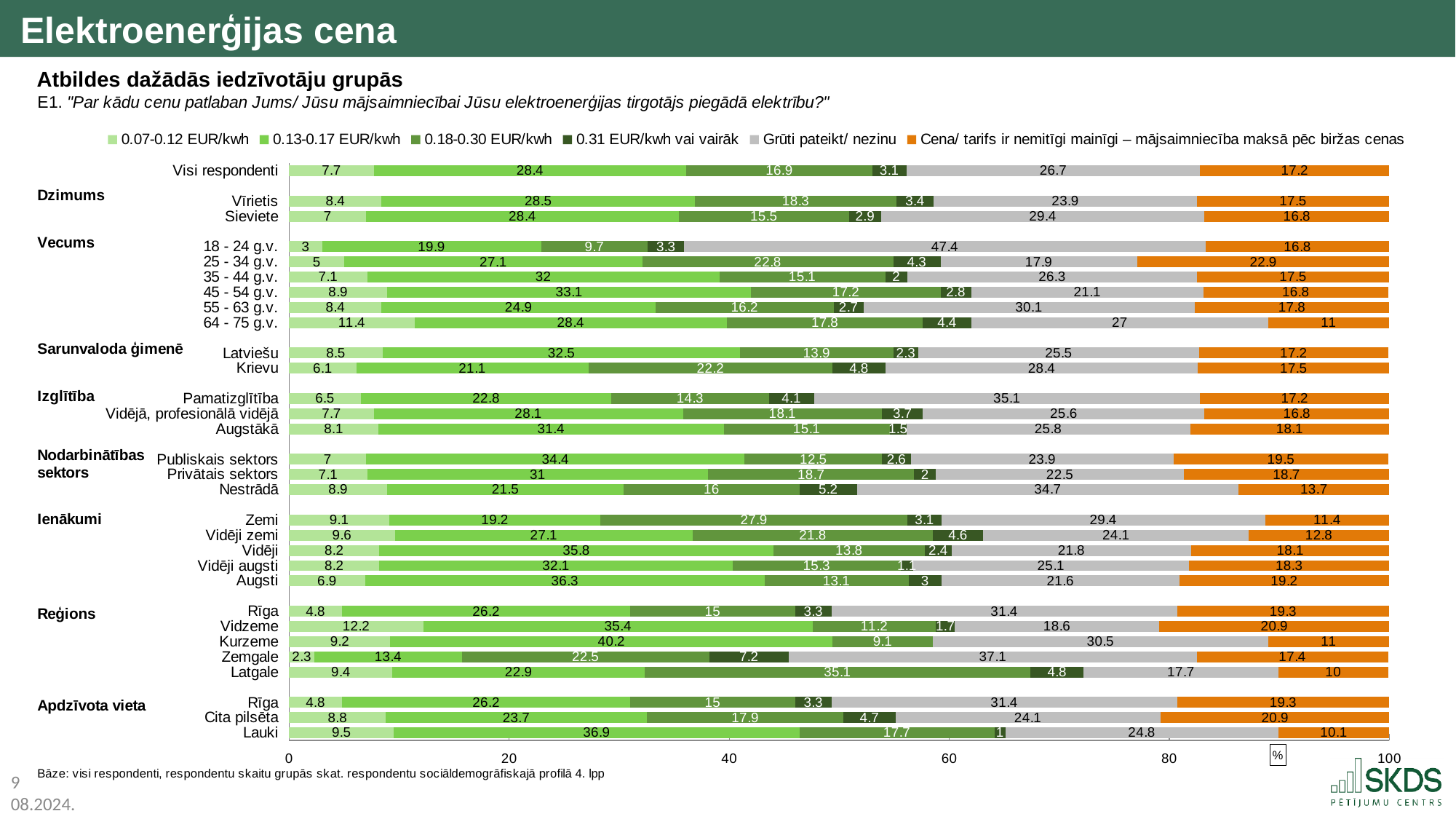
What kind of chart is shown on the slide? Stacked bar chart What percentage of all respondents (Visi respondenti) pay 0.13-0.17 EUR/kwh? 28.4 Among the Vecums (age) groups, which has the highest 'Grūti pateikt/ nezinu' value? 18 - 24 g.v. What is the value of 'Grūti pateikt/ nezinu' for the 18 - 24 g.v. age group? 47.4 Which age group has a larger 'Cena/ tarifs ir nemitīgi mainīgi' value: 25 - 34 g.v. or 18 - 24 g.v.? 25 - 34 g.v. Among the Reģions groups, which has the lowest value for 'Cena/ tarifs ir nemitīgi mainīgi – mājsaimniecība maksā pēc biržas cenas'? Latgale How many series does the legend list? 6 Among the Reģions groups, which has the highest 0.13-0.17 EUR/kwh value? Kurzeme What is the difference between the 'Grūti pateikt/ nezinu' values for Sieviete and Vīrietis? 5.5 How many age groups are listed under Vecums? 6 What is the value of the 0.13-0.17 EUR/kwh segment for Kurzeme? 40.2 What is the value of the 0.18-0.30 EUR/kwh segment for Latgale? 35.1